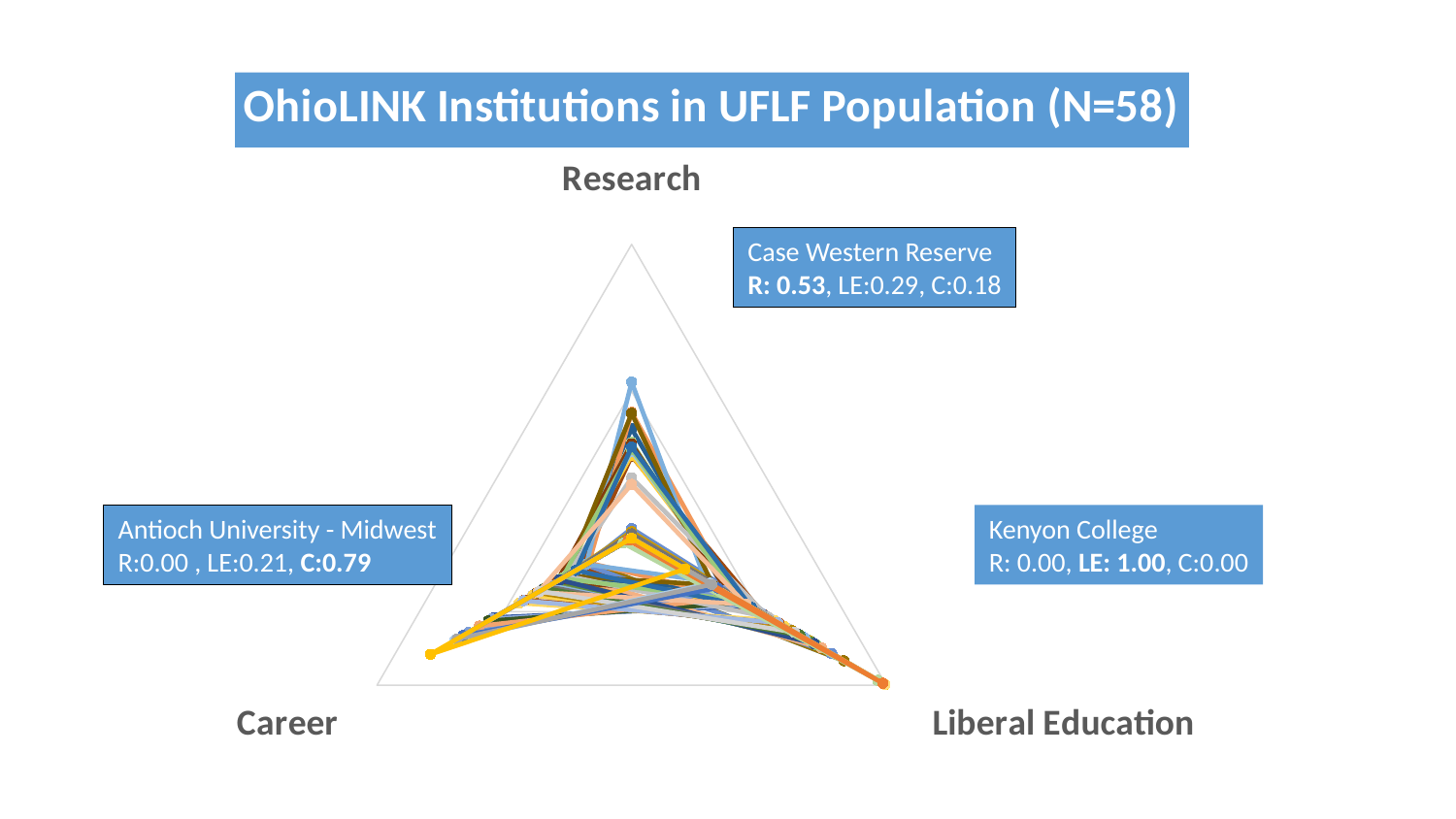
What is the difference between the Career (C) values of Antioch University - Midwest and Case Western Reserve? 0.61 Which of the three labeled institutions has the highest Research (R) value? Case Western Reserve What is the Liberal Education (LE) value for Kenyon College? 1.00 How many axes (categories) does the radar chart have? 3 What is the Career (C) value for Antioch University - Midwest? 0.79 What are the three axis labels on the radar chart? Research, Career, Liberal Education What kind of chart is shown on the slide? Radar chart Which is larger: the Liberal Education value for Kenyon College or for Antioch University - Midwest? Kenyon College What is the title of the chart? OhioLINK Institutions in UFLF Population (N=58) What is the Research (R) value for Case Western Reserve? 0.53 Which of the three labeled institutions has the highest Career (C) value? Antioch University - Midwest What is the Liberal Education (LE) value for Case Western Reserve? 0.29